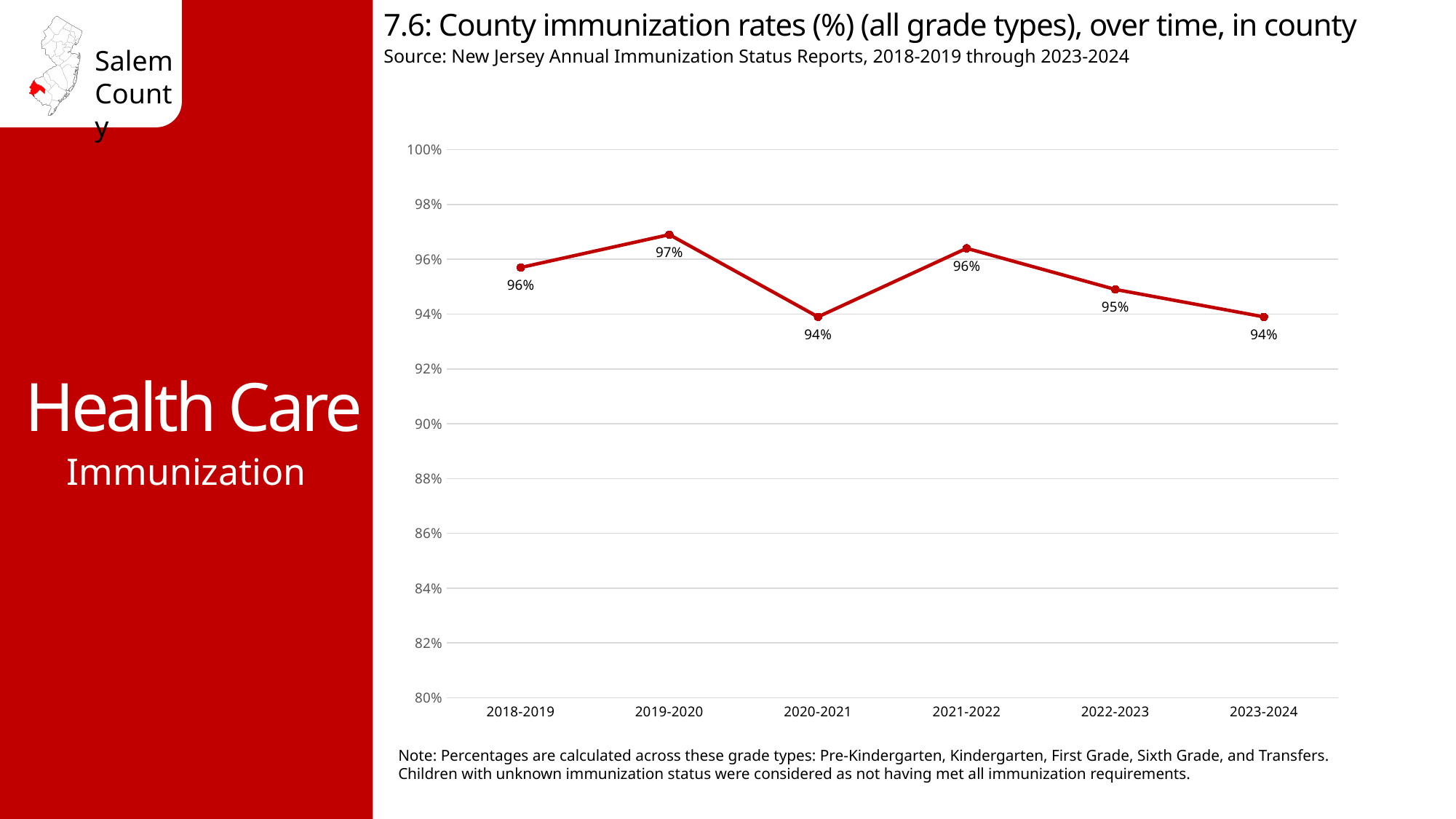
Which has a higher immunization rate, 2019-2020 or 2022-2023? 2019-2020 What is the source cited for the chart data? New Jersey Annual Immunization Status Reports, 2018-2019 through 2023-2024 What kind of chart is shown on the slide? line chart What is the county immunization rate for 2023-2024? 94% What is the county immunization rate for 2019-2020? 97% Is the immunization rate for 2020-2021 greater or less than 90%? greater What is the county immunization rate for 2018-2019? 96% What is the county immunization rate for 2022-2023? 95% What is the difference in percentage points between the immunization rate in 2019-2020 and in 2020-2021? 3 Does the immunization rate rise or fall from 2021-2022 to 2023-2024? fall How many school years are plotted on the chart? 6 Which school year has the highest county immunization rate? 2019-2020